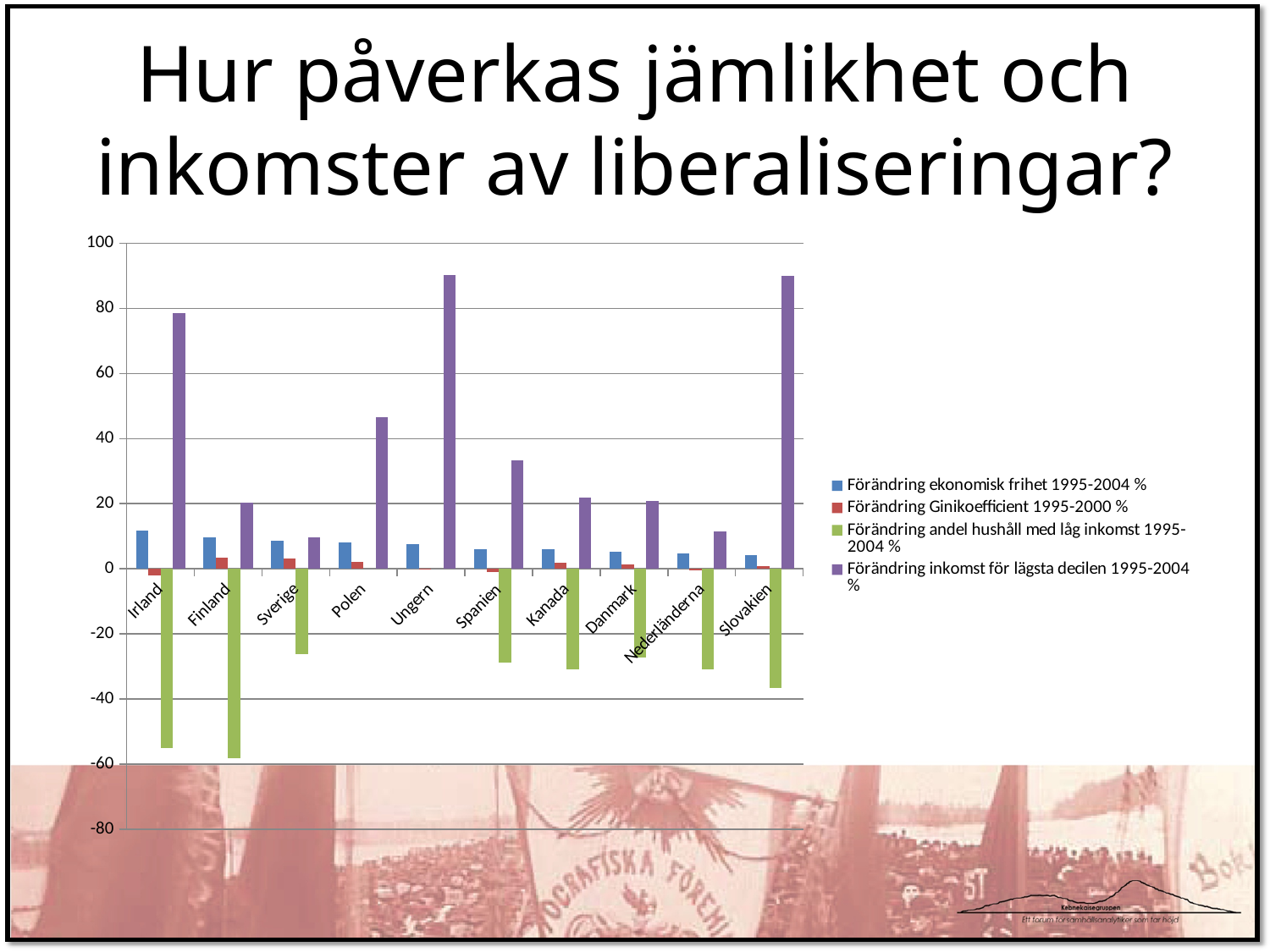
Is the value for Irland in the series 'Förändring inkomst för lägsta decilen 1995-2004 %' greater or less than 60? greater How many series does the chart's legend list? 4 Which is larger for 'Förändring inkomst för lägsta decilen 1995-2004 %': Polen or Spanien? Polen Is the value for Sverige in the series 'Förändring andel hushåll med låg inkomst 1995-2004 %' greater or less than -20? less What kind of chart is shown on the slide? bar chart Which is larger for 'Förändring ekonomisk frihet 1995-2004 %': Irland or Slovakien? Irland Which country has the highest value for 'Förändring ekonomisk frihet 1995-2004 %'? Irland How many countries are shown on the x axis of the chart? 10 Is the value for Slovakien in the series 'Förändring inkomst för lägsta decilen 1995-2004 %' greater or less than 80? greater Which colour represents the series 'Förändring Ginikoefficient 1995-2000 %' in the chart? red